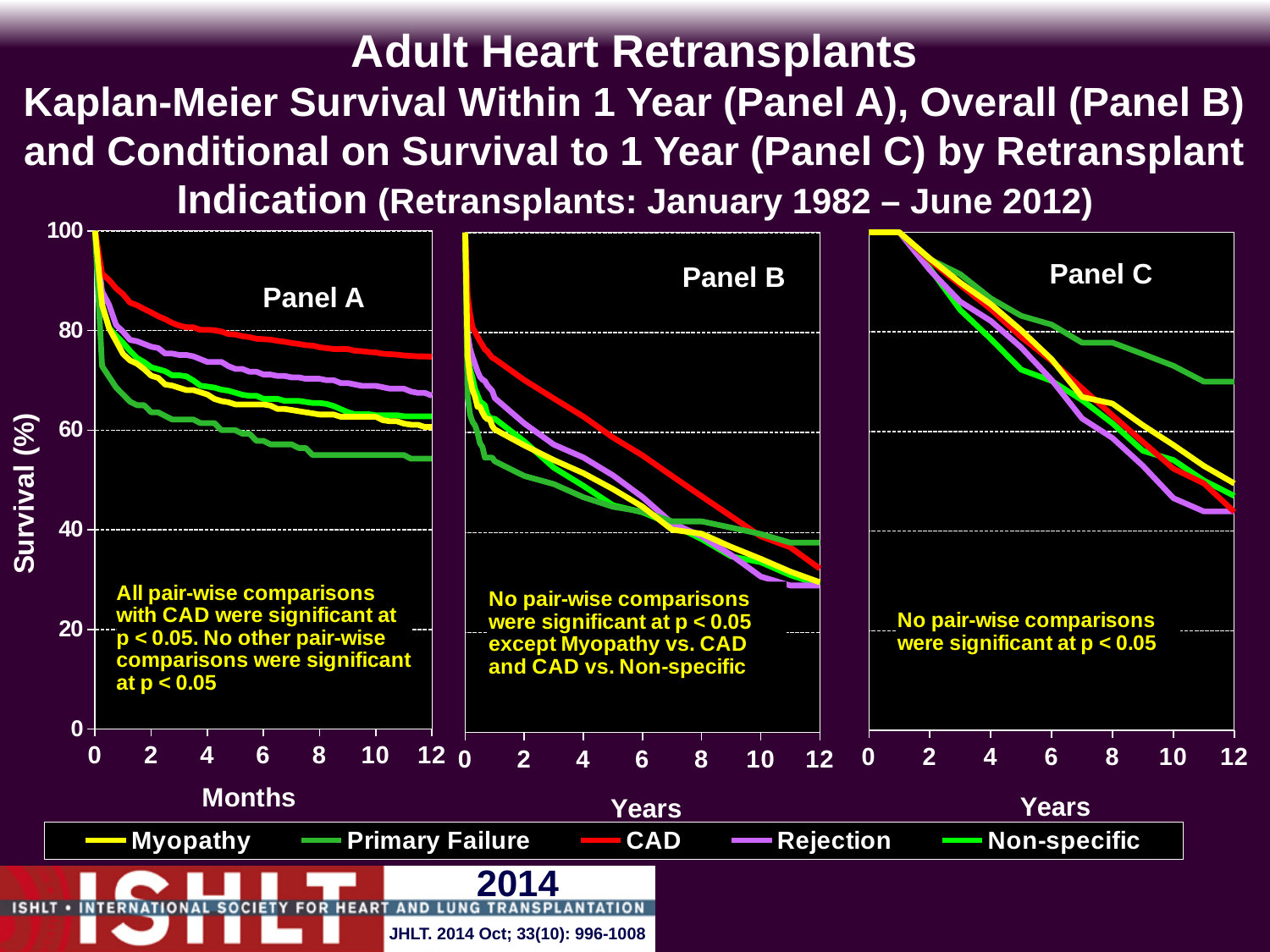
In Panel A, which indication has the lowest survival at 12 months? Primary Failure In Panel B, is the survival for CAD at 6 years greater or less than 40? greater What is the x-axis label of Panel A? Months In Panel C, do the survival curves rise or fall as years increase? fall In Panel A, which indication has the highest survival at 12 months? CAD In Panel C, is the survival for Rejection at 10 years greater or less than 60? less In Panel C, which indication has the highest survival at 12 years? Primary Failure What kind of chart is Panel A? line chart In Panel A, is the survival for Primary Failure at 12 months greater or less than 60? less How many series does the legend list? 5